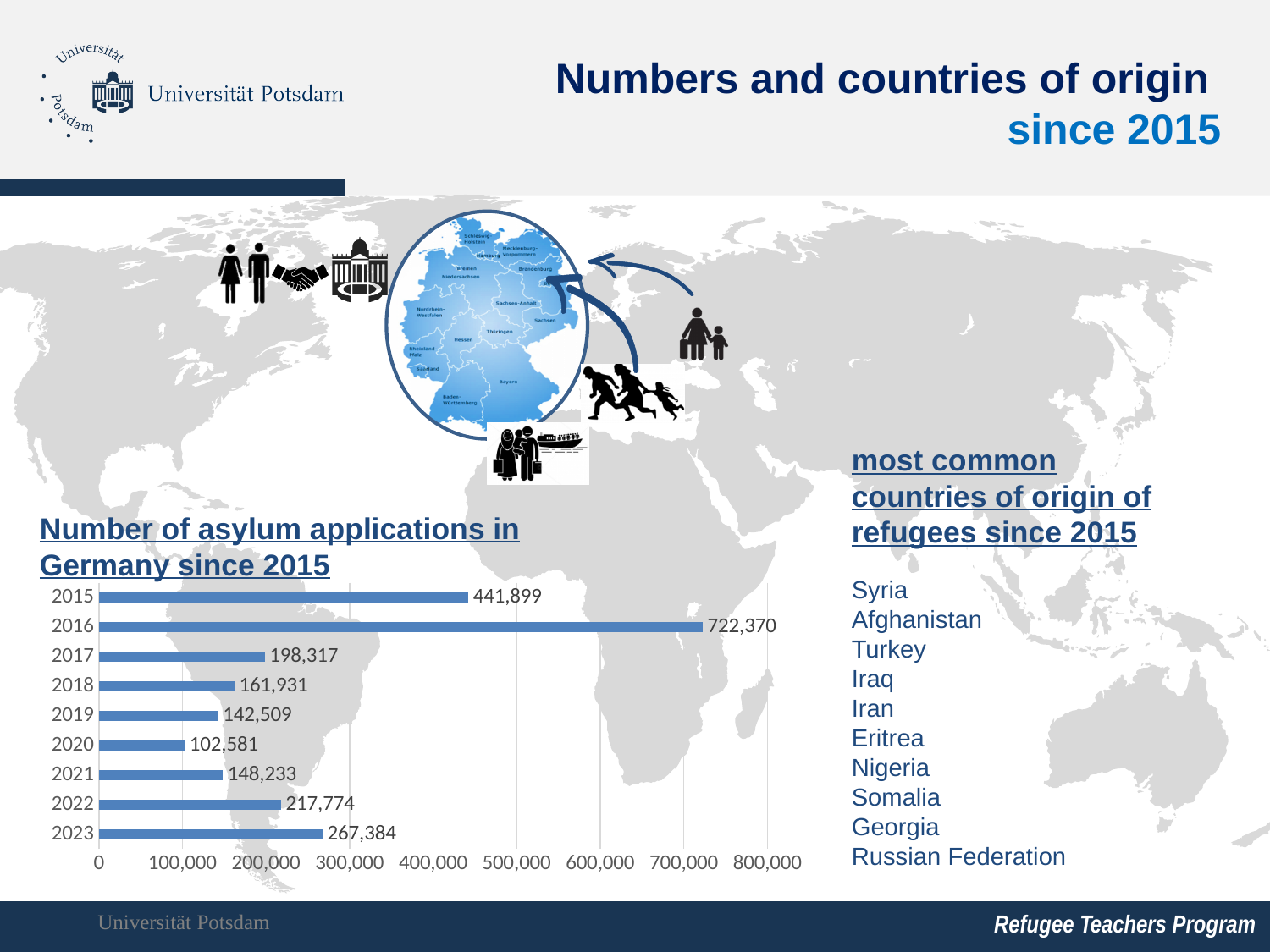
What kind of chart is used to show the number of asylum applications in Germany? bar chart Which year has the lowest number of asylum applications in Germany? 2020 What is the difference between the number of asylum applications in 2023 and in 2022? 49,610 What is the number of asylum applications in Germany in 2016? 722,370 Do the number of asylum applications rise or fall from 2016 to 2020? fall How many years are shown in the asylum applications chart? 9 What is the difference between the number of asylum applications in 2016 and in 2015? 280,471 Which year has the highest number of asylum applications in Germany? 2016 What is the number of asylum applications in Germany in 2023? 267,384 Which year had more asylum applications, 2019 or 2021? 2021 Is the number of asylum applications in 2015 greater or less than 400,000? greater What is the number of asylum applications in Germany in 2020? 102,581